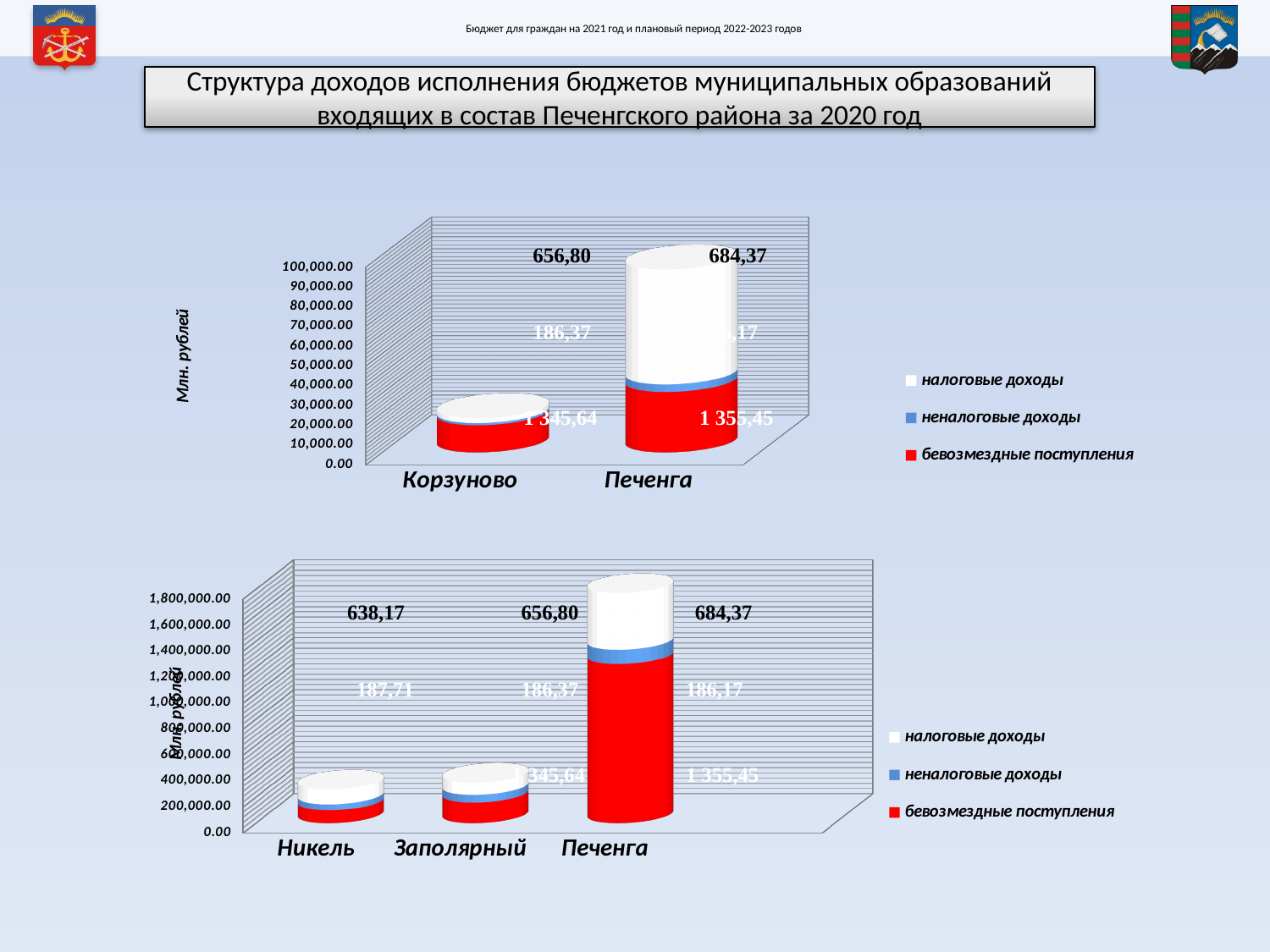
How many series does the legend of the top chart list? 3 In the bottom chart, which series is shown in red according to the legend? безвозмездные поступления How many categories are shown on the x axis of the bottom chart? 3 What kind of chart is the top chart on the slide? bar chart In the top chart, which category has the taller stacked bar, Корзуново or Печенга? Печенга In the bottom chart, which category has the tallest stacked bar? Печенга